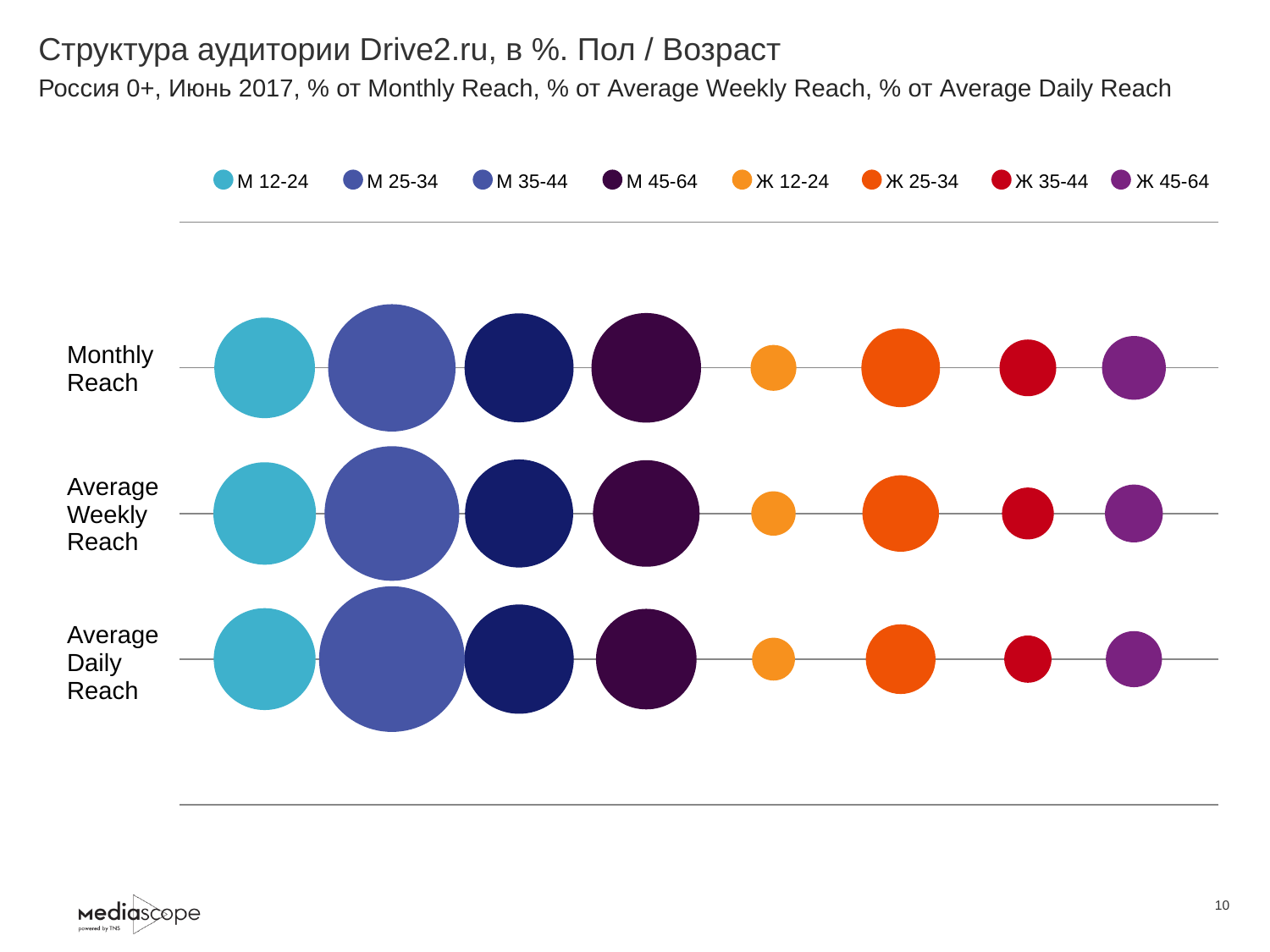
Which legend entry is shown in orange? Ж 25-34 Which group has the largest bubble in the Average Daily Reach row? М 25-34 In the Average Weekly Reach row, which bubble is larger: М 25-34 or Ж 12-24? М 25-34 How many series does the legend list? 8 In the Monthly Reach row, which bubble is larger: М 12-24 or Ж 45-64? М 12-24 In the Average Daily Reach row, which bubble is larger: М 45-64 or Ж 35-44? М 45-64 How many reach categories (rows) are plotted on the chart? 3 What are the three row labels on the chart? Monthly Reach, Average Weekly Reach, Average Daily Reach Which group has the largest bubble in the Monthly Reach row? М 25-34 What kind of chart is shown on the slide? bubble chart